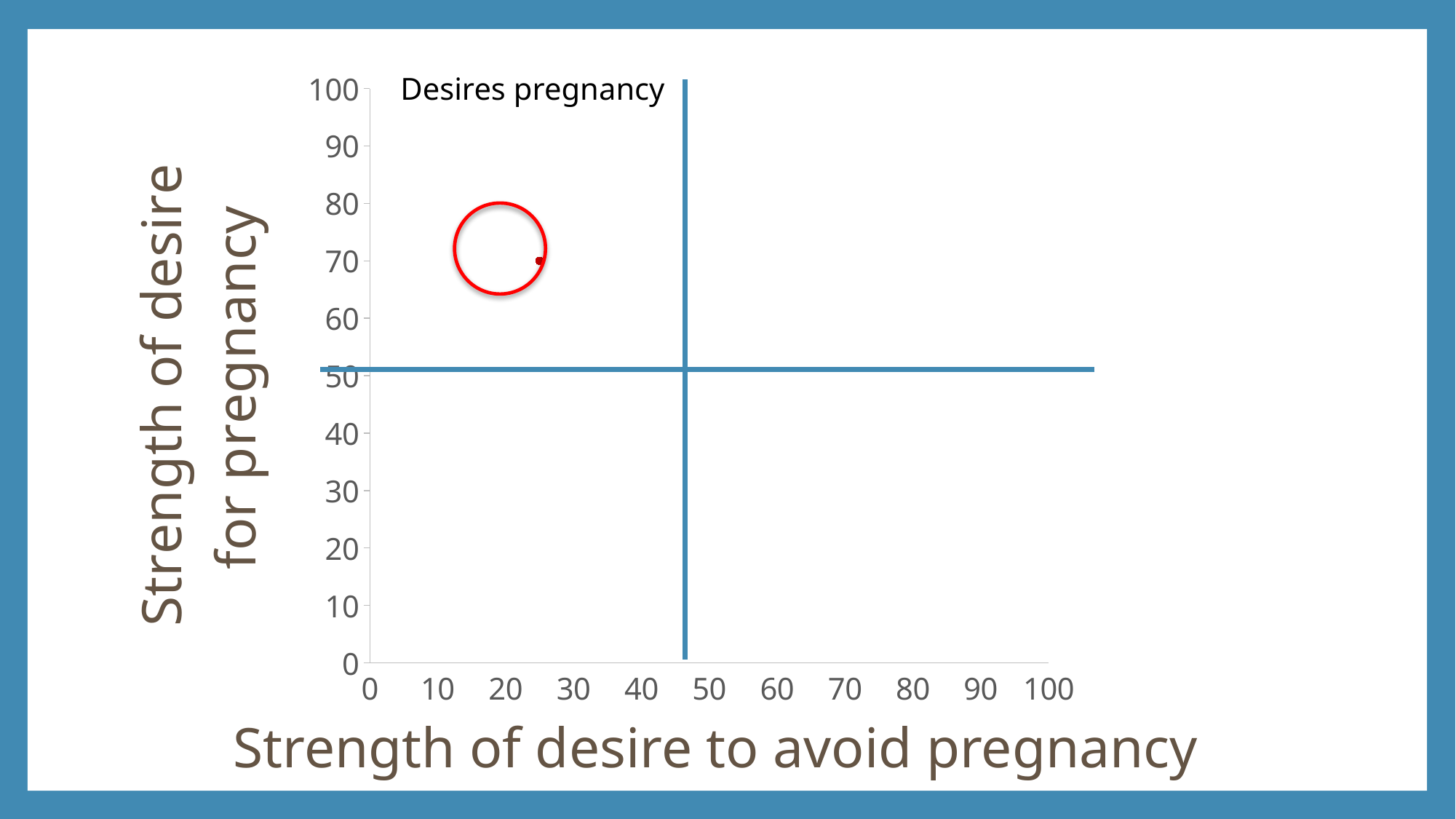
Is the plotted point's value on the horizontal axis greater or less than 40? less How many data points are plotted on the chart? 1 What label is written in the upper-left quadrant of the chart? Desires pregnancy What kind of chart is shown on the slide? scatter chart What is the title of the horizontal axis? Strength of desire to avoid pregnancy Is the plotted point's value on the vertical axis greater or less than 80? less Is the plotted point's value on the vertical axis (strength of desire for pregnancy) greater or less than 50? greater